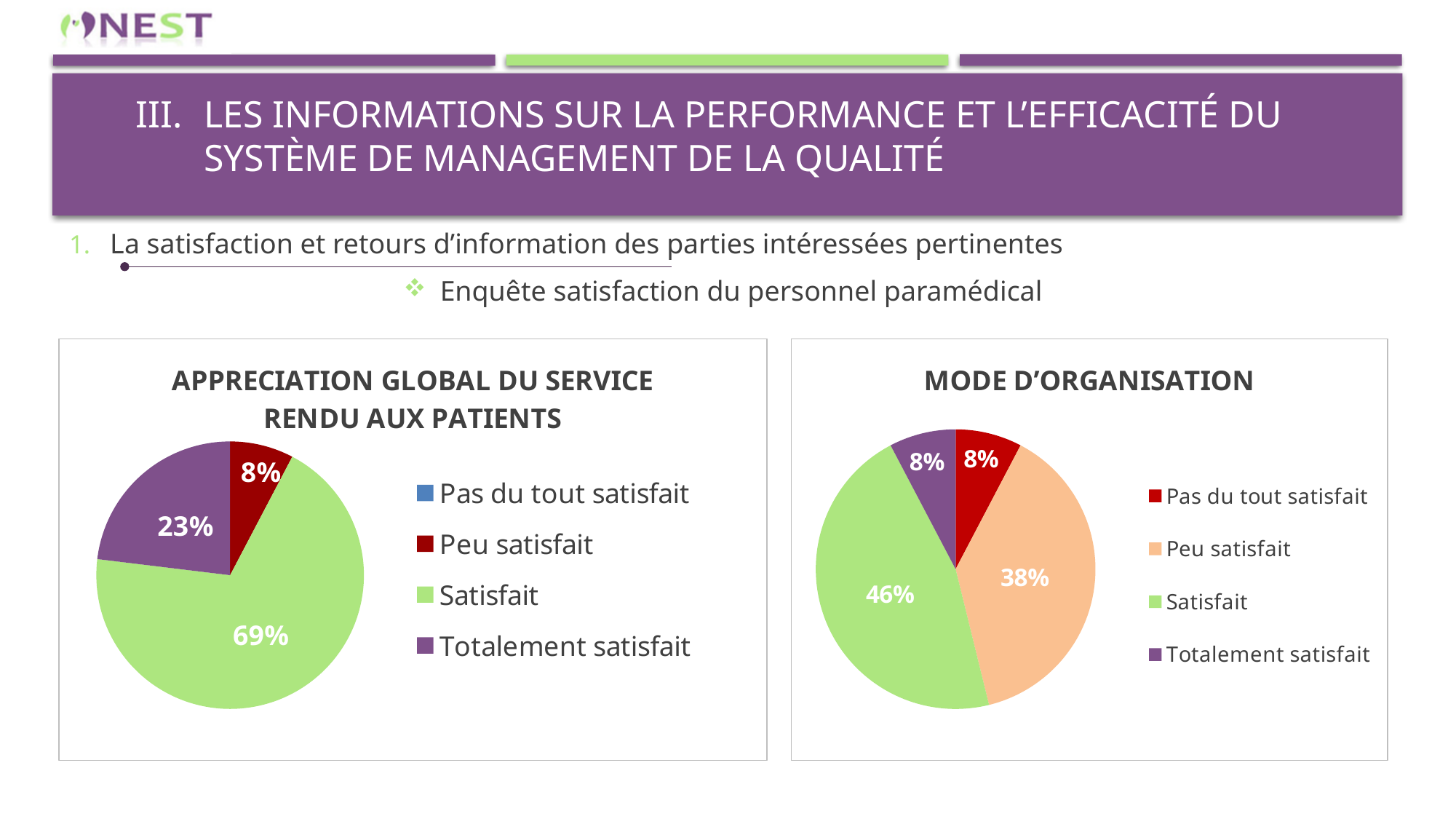
In the chart titled "MODE D'ORGANISATION", which category has the largest slice? Satisfait In the chart titled "APPRECIATION GLOBAL DU SERVICE RENDU AUX PATIENTS", what percentage is shown for Satisfait? 69% In the chart titled "APPRECIATION GLOBAL DU SERVICE RENDU AUX PATIENTS", what percentage is shown for Peu satisfait? 8% In the chart titled "MODE D'ORGANISATION", what percentage is shown for Pas du tout satisfait? 8% In the chart titled "APPRECIATION GLOBAL DU SERVICE RENDU AUX PATIENTS", what is the difference in percentage points between Satisfait and Totalement satisfait? 46 In the chart titled "APPRECIATION GLOBAL DU SERVICE RENDU AUX PATIENTS", what percentage is shown for Totalement satisfait? 23% How many entries does the legend of the chart titled "APPRECIATION GLOBAL DU SERVICE RENDU AUX PATIENTS" list? 4 In the chart titled "MODE D'ORGANISATION", which is larger, Peu satisfait or Totalement satisfait? Peu satisfait What kind of chart is the chart titled "MODE D'ORGANISATION"? Pie chart In the chart titled "MODE D'ORGANISATION", what percentage is shown for Satisfait? 46% In the chart titled "APPRECIATION GLOBAL DU SERVICE RENDU AUX PATIENTS", which category has the largest slice? Satisfait In the chart titled "MODE D'ORGANISATION", what percentage is shown for Peu satisfait? 38%